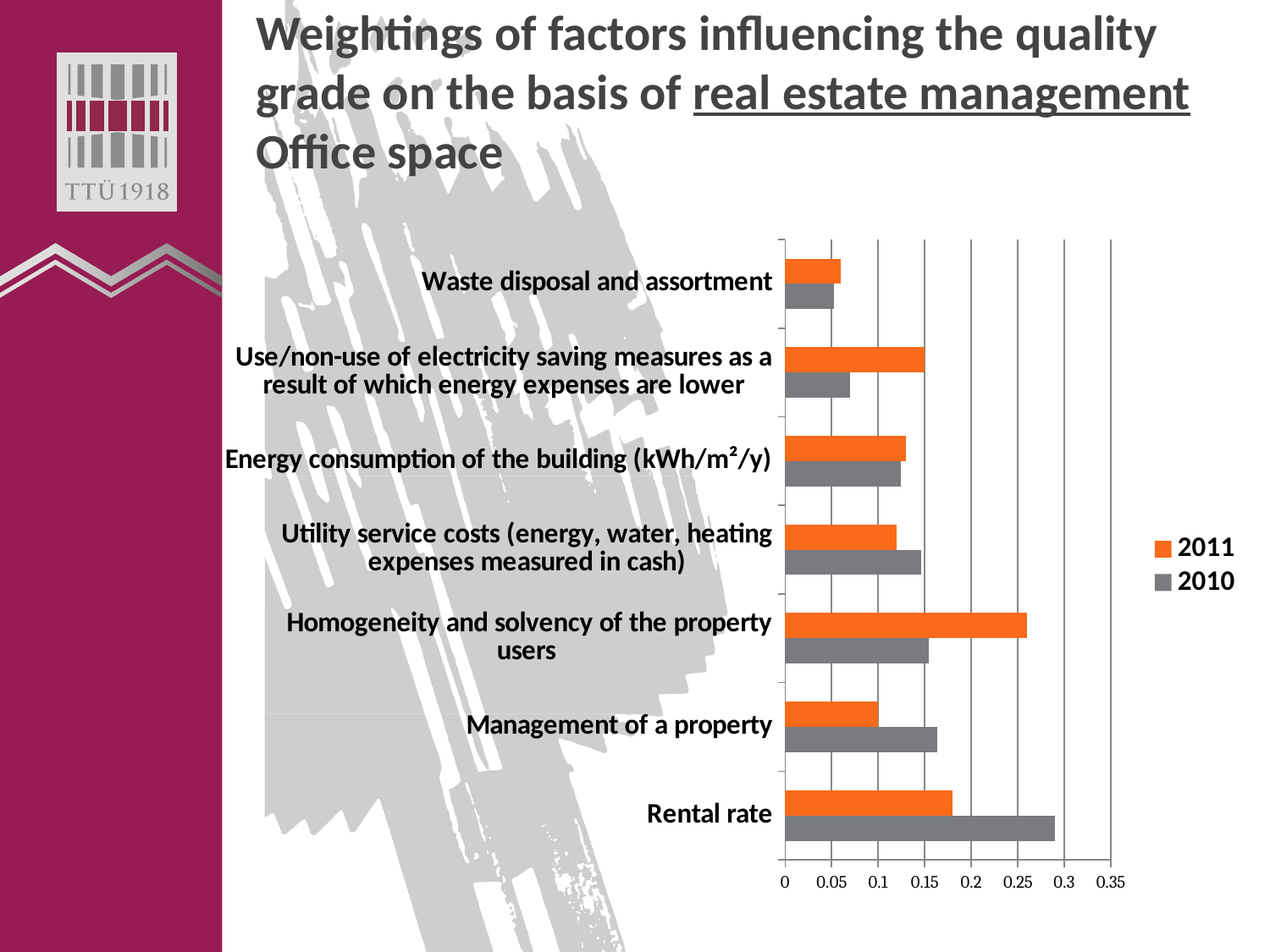
How many factor categories are plotted on the chart? 7 Which factor has the lowest 2011 weighting? Waste disposal and assortment What kind of chart is shown on the slide? bar chart Which factor has the lowest 2010 weighting? Waste disposal and assortment Which factor has the highest 2010 weighting? Rental rate For Rental rate, which year has the larger weighting, 2011 or 2010? 2010 For Management of a property, which year has the larger weighting, 2011 or 2010? 2010 Which factor has the highest 2011 weighting? Homogeneity and solvency of the property users Which colour represents the 2011 series in the legend? orange Is the 2010 value for Use/non-use of electricity saving measures as a result of which energy expenses are lower greater or less than 0.1? less How many series does the legend list? 2 Is the 2011 value for Homogeneity and solvency of the property users greater or less than 0.2? greater